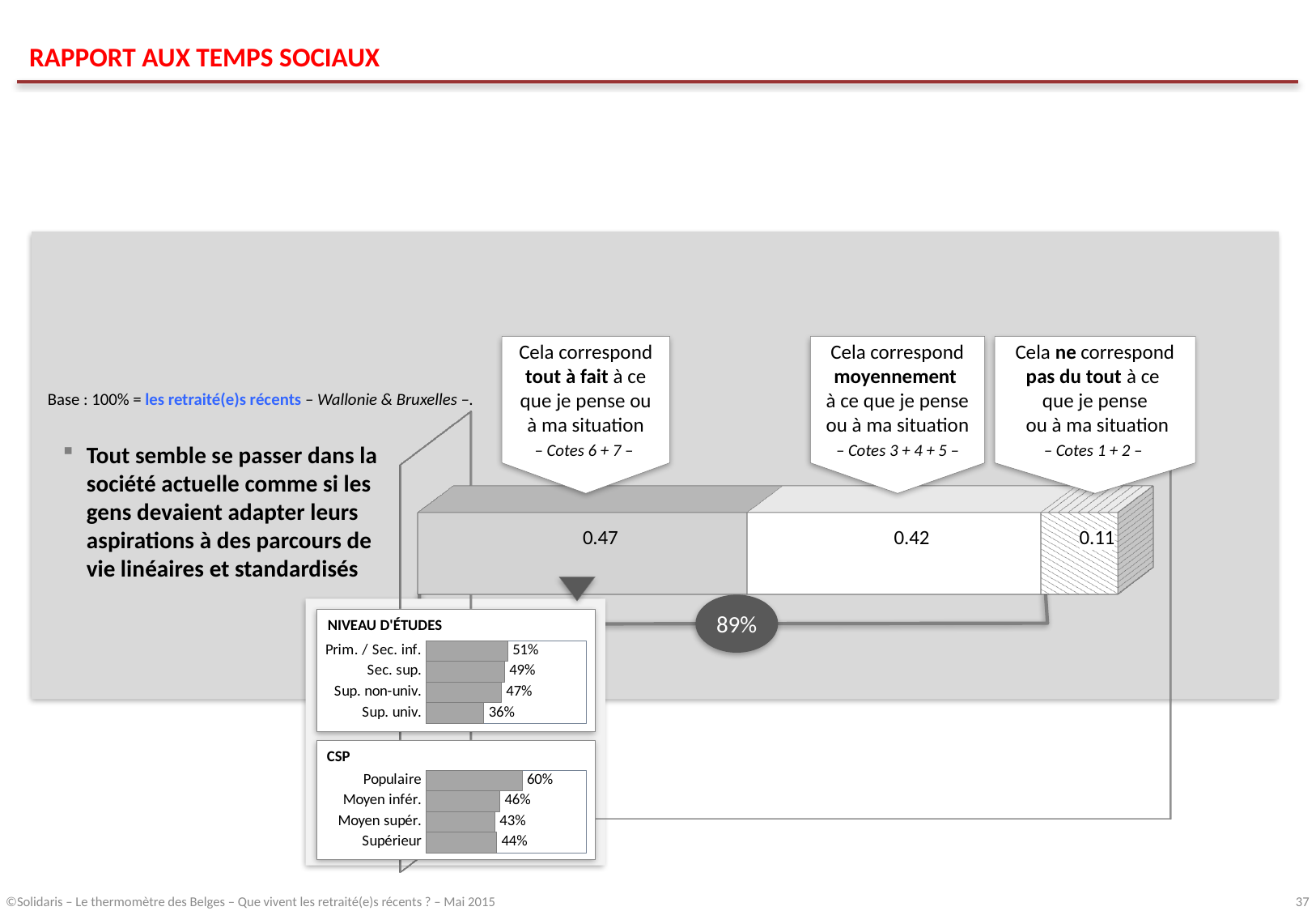
In the NIVEAU D'ÉTUDES chart, what is the difference between Prim. / Sec. inf. and Sup. univ.? 15 percentage points In the NIVEAU D'ÉTUDES chart, which category has the highest value? Prim. / Sec. inf. In the CSP chart, what is the value for Populaire? 60% In the large stacked bar, what is the value for the segment 'Cela ne correspond pas du tout à ce que je pense ou à ma situation'? 0.11 In the CSP chart, which category has the lowest value? Moyen supér. What kind of chart is the CSP chart? Bar chart In the NIVEAU D'ÉTUDES chart, what is the value for Sup. univ.? 36% In the large stacked bar, what is the value for the segment 'Cela correspond tout à fait à ce que je pense ou à ma situation'? 0.47 In the CSP chart, what is the difference between Populaire and Moyen supér.? 17 percentage points In the CSP chart, which is larger: Moyen infér. or Supérieur? Moyen infér. In the NIVEAU D'ÉTUDES chart, how many categories are shown? 4 In the large stacked bar, what is the combined value of the 'tout à fait' and 'moyennement' segments, as shown in the circle below the bar? 89%